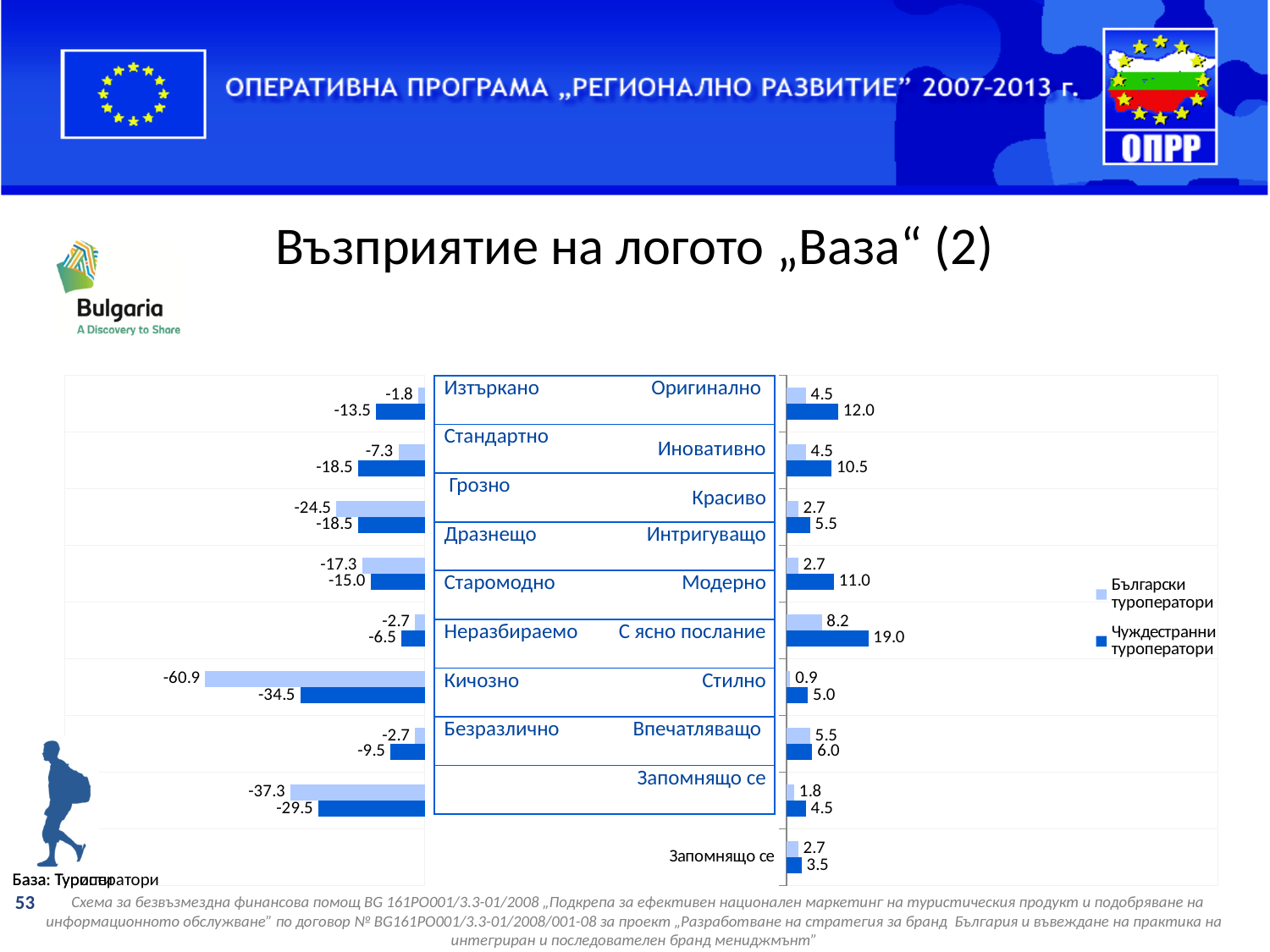
In the bottom row labelled „Запомнящо се“, what is the difference between the Чуждестранни туроператори value and the Български туроператори value? 0.8 What is the title of the slide containing the chart? Възприятие на логото „Ваза“ (2) In the bottom row labelled „Запомнящо се“, what is the value for Чуждестранни туроператори? 3.5 How many series does the chart legend list? 2 In the bottom row labelled „Запомнящо се“, which series has the larger value? Чуждестранни туроператори What is the largest positive value labelled on the chart? 19.0 What is the most negative value labelled on the chart? -60.9 In the bottom row labelled „Запомнящо се“, what is the value for Български туроператори? 2.7 What are the two series named in the chart legend? Български туроператори and Чуждестранни туроператори Which series does the value 19.0 belong to? Чуждестранни туроператори What kind of chart is shown on the slide? bar chart Which series does the value -60.9 belong to? Български туроператори